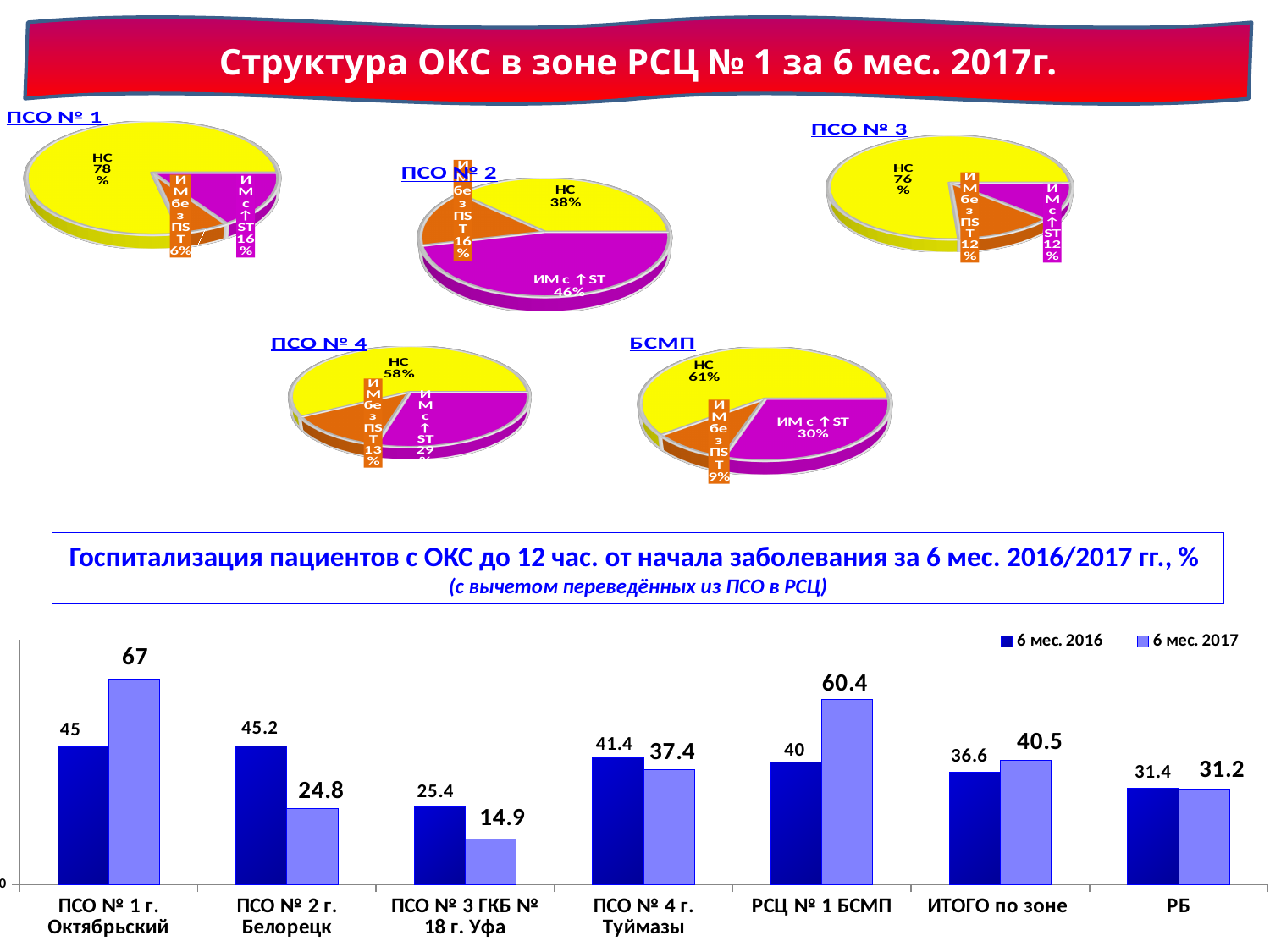
In the bottom bar chart, what is the difference between the 6 мес. 2017 and 6 мес. 2016 values for ПСО № 2 г. Белорецк? 20.4 In the bottom bar chart, what is the value for ПСО № 3 ГКБ № 18 г. Уфа for 6 мес. 2016? 25.4 In the БСМП pie chart, which slice is the largest? НС In the ПСО № 2 pie chart, what share is ИМ с ↑ST? 46% In the ПСО № 3 pie chart, what share is ИМ без ПST? 12% In the bottom bar chart, what is the value for РСЦ № 1 БСМП for 6 мес. 2017? 60.4 How many series does the legend of the bottom bar chart list? 2 In the bottom bar chart, which category has the highest 6 мес. 2017 value? ПСО № 1 г. Октябрьский In the ПСО № 1 pie chart, what share is НС? 78% How many categories are shown on the x axis of the bottom bar chart? 7 In the bottom bar chart, which is larger for ИТОГО по зоне: 6 мес. 2016 or 6 мес. 2017? 6 мес. 2017 In the ПСО № 4 pie chart, which slice is the smallest? ИМ без ПST